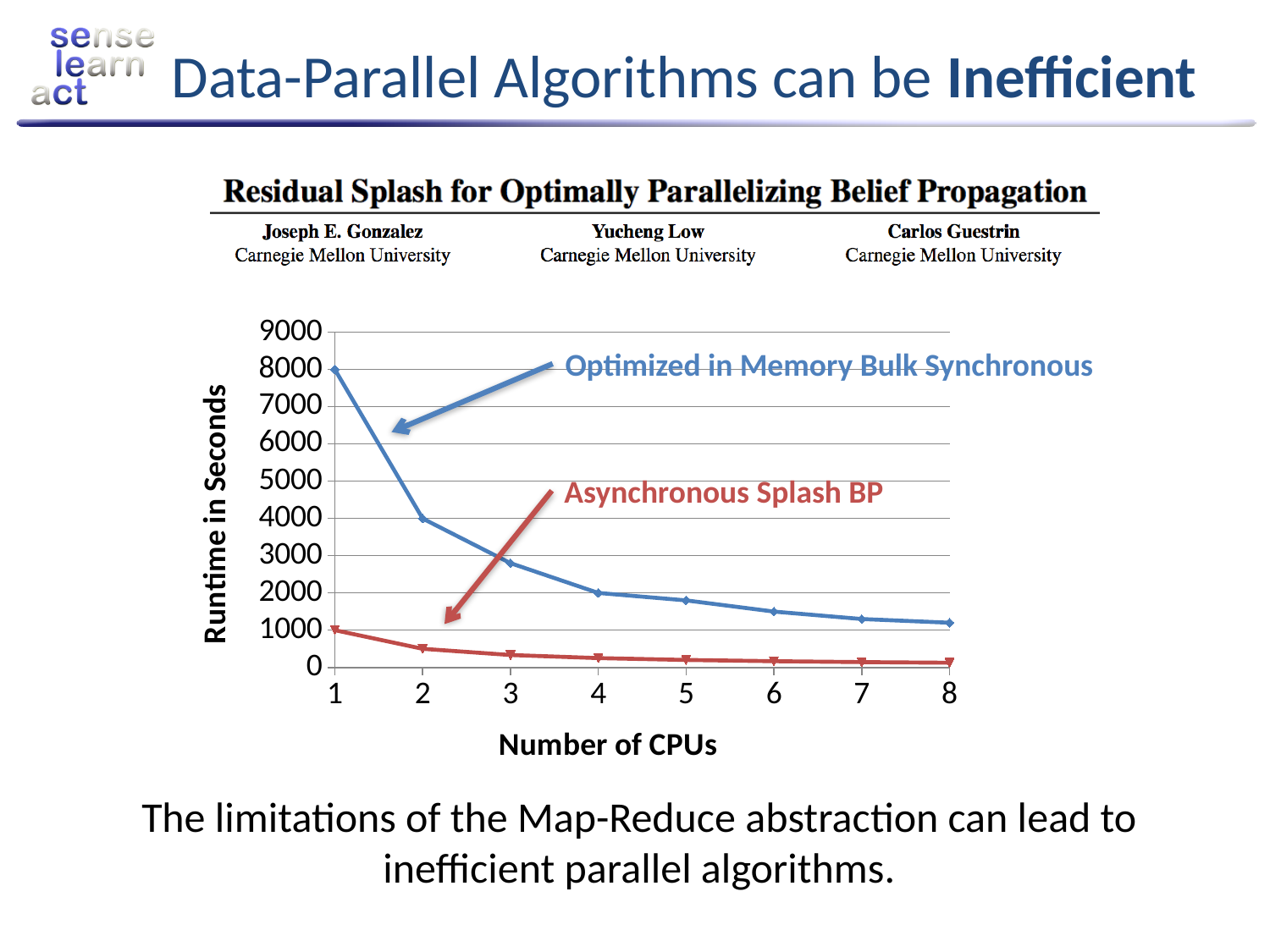
Is the runtime for Optimized in Memory Bulk Synchronous at 8 CPUs greater or less than 2000? less How many data series are plotted in the chart? 2 What is the runtime in seconds for Optimized in Memory Bulk Synchronous at 1 CPU? 8000 As the number of CPUs increases, does the runtime for Optimized in Memory Bulk Synchronous rise or fall? fall At which number of CPUs is the runtime for Optimized in Memory Bulk Synchronous highest? 1 Is the runtime for Asynchronous Splash BP at 4 CPUs greater or less than 1000? less What is the title of the y axis? Runtime in Seconds How many CPU counts are plotted along the x axis? 8 At 3 CPUs, which series has the higher runtime, Optimized in Memory Bulk Synchronous or Asynchronous Splash BP? Optimized in Memory Bulk Synchronous What is the title of the x axis? Number of CPUs What kind of chart is shown on the slide? line chart